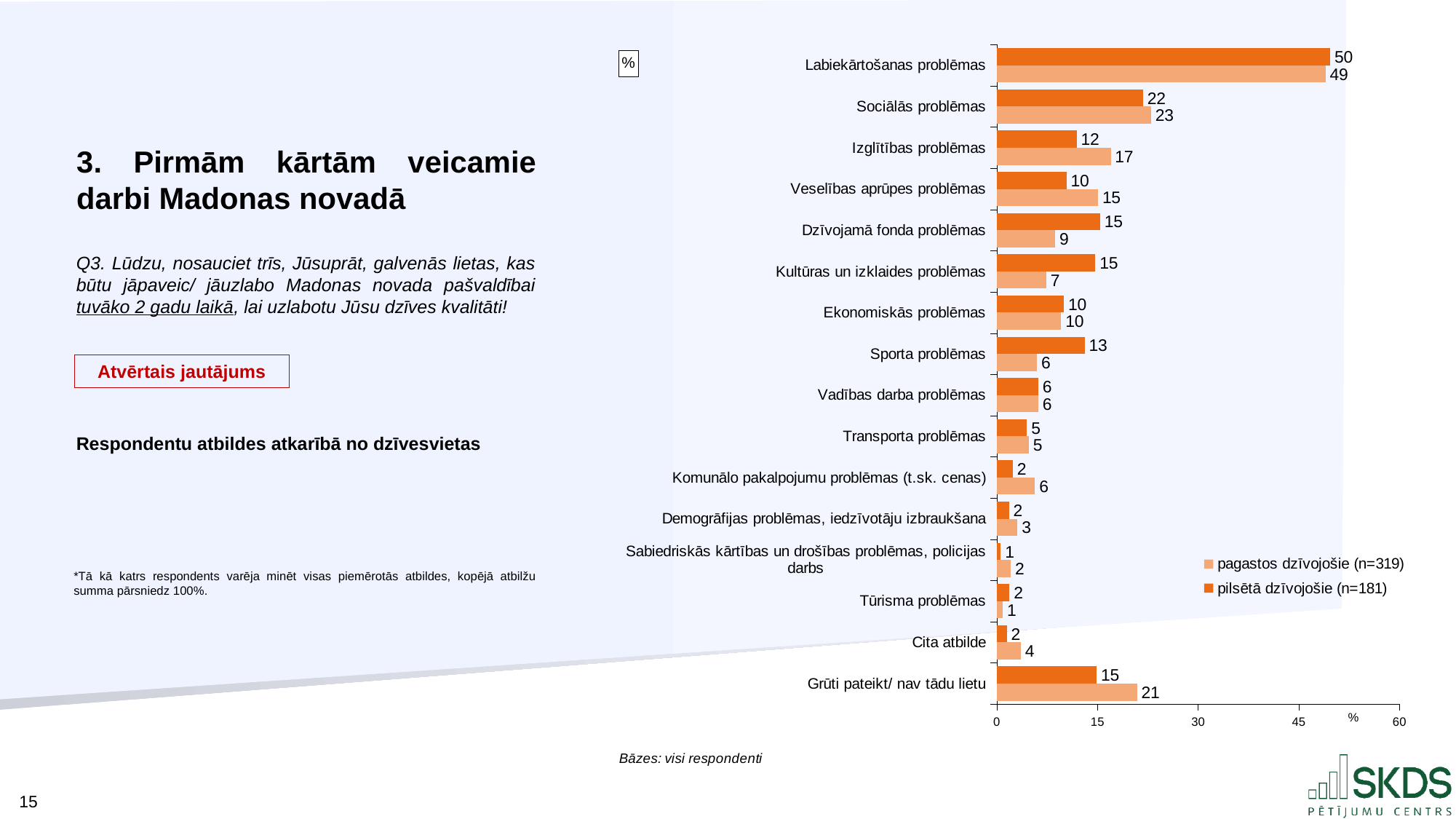
What is the value for 'Grūti pateikt/ nav tādu lietu' among pagastos dzīvojošie (n=319)? 21 What is the value for 'Izglītības problēmas' among pagastos dzīvojošie (n=319)? 17 What kind of chart is shown on the slide? bar chart For 'Sporta problēmas', which group has the larger value: pilsētā dzīvojošie or pagastos dzīvojošie? pilsētā dzīvojošie What is the difference between the pagastos dzīvojošie and pilsētā dzīvojošie values for 'Kultūras un izklaides problēmas'? 8 Is the value for 'Sociālās problēmas' among pagastos dzīvojošie greater or less than 15? greater What is the difference between the pagastos dzīvojošie and pilsētā dzīvojošie values for 'Veselības aprūpes problēmas'? 5 How many series does the legend list? 2 What is the value for 'Labiekārtošanas problēmas' among pilsētā dzīvojošie (n=181)? 50 Which category has the highest value for pagastos dzīvojošie (n=319)? Labiekārtošanas problēmas How many categories are shown on the chart? 16 Which category has the lowest value for pilsētā dzīvojošie (n=181)? Sabiedriskās kārtības un drošības problēmas, policijas darbs